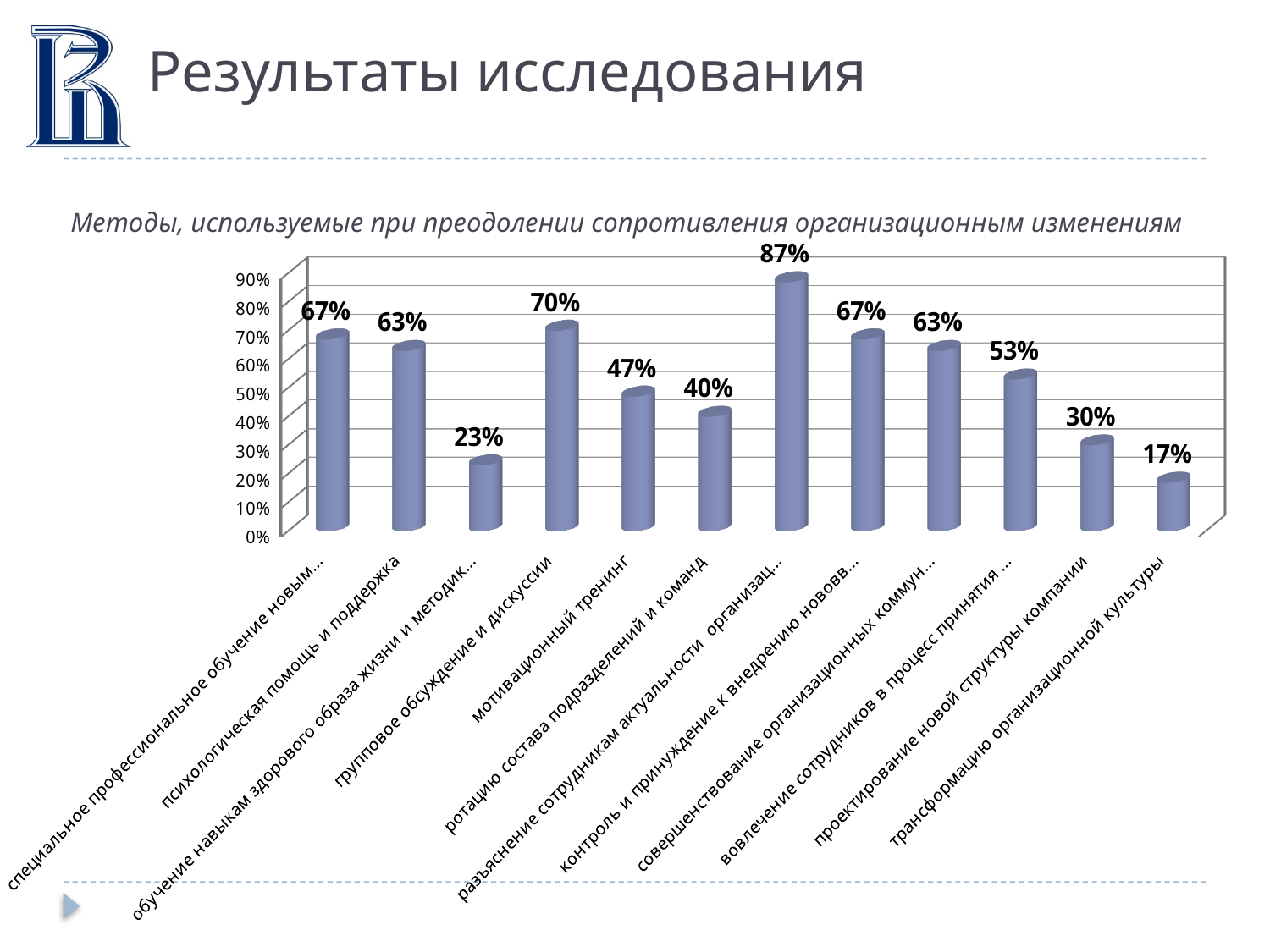
What is the highest value shown in the chart? 87% What type of chart is shown on the slide? bar chart What is the value for "психологическая помощь и поддержка"? 63% How many categories are plotted in the chart? 12 What is the value for "групповое обсуждение и дискуссии"? 70% What is the title of the chart? Методы, используемые при преодолении сопротивления организационным изменениям Which is larger: the value for "ротацию состава подразделений и команд" or the value for "проектирование новой структуры компании"? ротацию состава подразделений и команд What is the value for "проектирование новой структуры компании"? 30% What is the value for "мотивационный тренинг"? 47% Which category has the lowest value? трансформацию организационной культуры What is the difference between the values for "психологическая помощь и поддержка" and "трансформацию организационной культуры"? 46% What is the difference between the values for "групповое обсуждение и дискуссии" and "мотивационный тренинг"? 23%